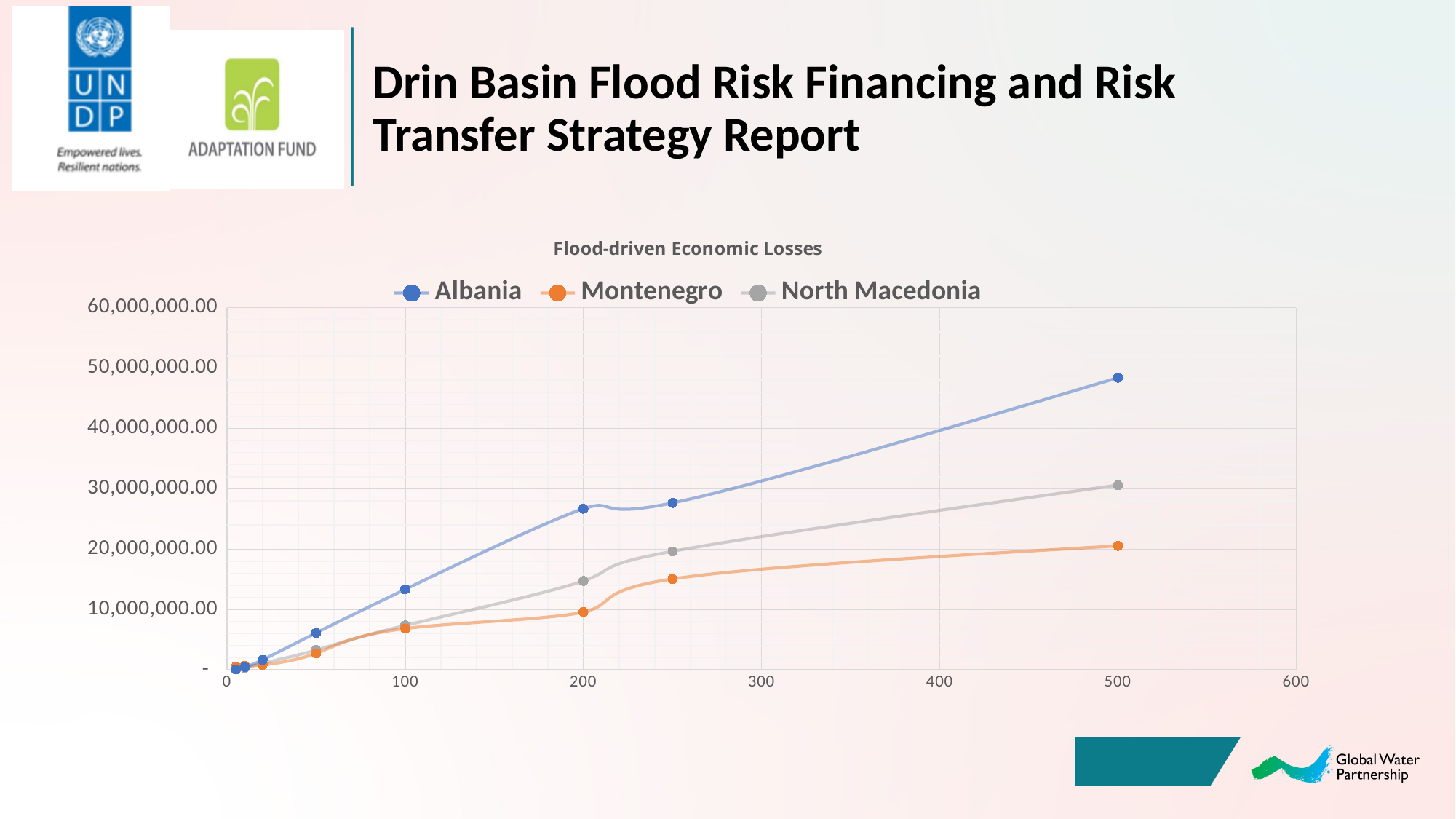
At x = 250, which is larger, the value for Albania or the value for North Macedonia? Albania How many series does the legend list? 3 What is the title of the chart? Flood-driven Economic Losses At x = 500, is the value for Montenegro greater or less than 30,000,000.00? less Which series is drawn in orange? Montenegro At x = 500, is the value for Albania greater or less than 40,000,000.00? greater At x = 200, is the value for Albania greater or less than 20,000,000.00? greater Do the values for Albania rise or fall as x increases from 0 to 500? rise What kind of chart is shown on the slide? line chart Which series has the highest value at x = 500? Albania Which series has the lowest value at x = 500? Montenegro